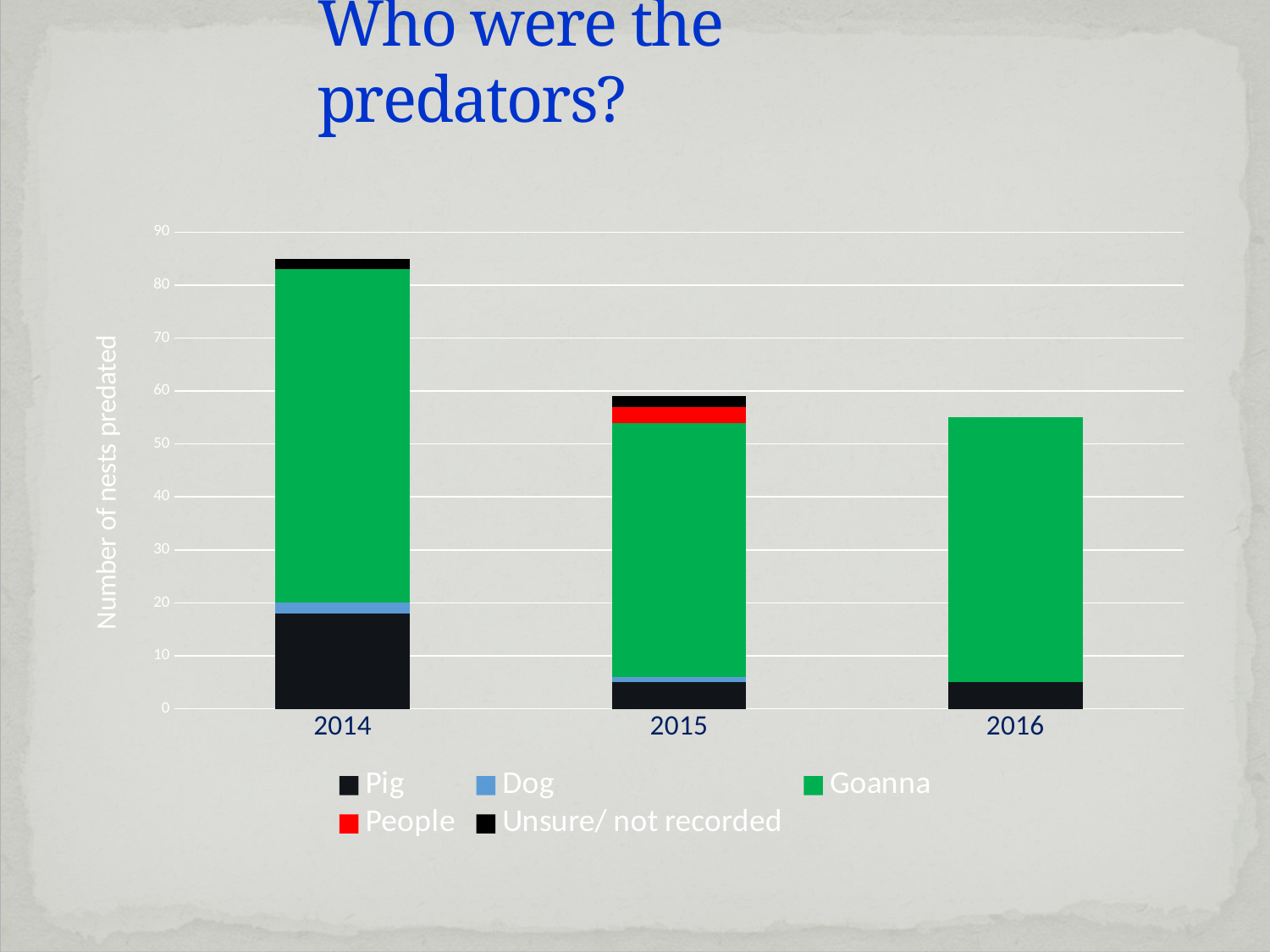
Which predator series is shown in green in the chart? Goanna Is the total number of nests predated in 2014 greater or less than 80? greater What is the label on the vertical axis of the chart? Number of nests predated Is the total number of nests predated in 2016 greater or less than 50? greater Is the Pig segment for 2014 greater or less than 10? greater Which year has a larger total number of nests predated, 2014 or 2015? 2014 How many years are shown on the x axis of the chart? 3 Which year has the highest total number of nests predated? 2014 How many series does the chart's legend list? 5 Do the total numbers of nests predated rise or fall from 2014 to 2016? fall What kind of chart is shown on the slide? Stacked bar chart